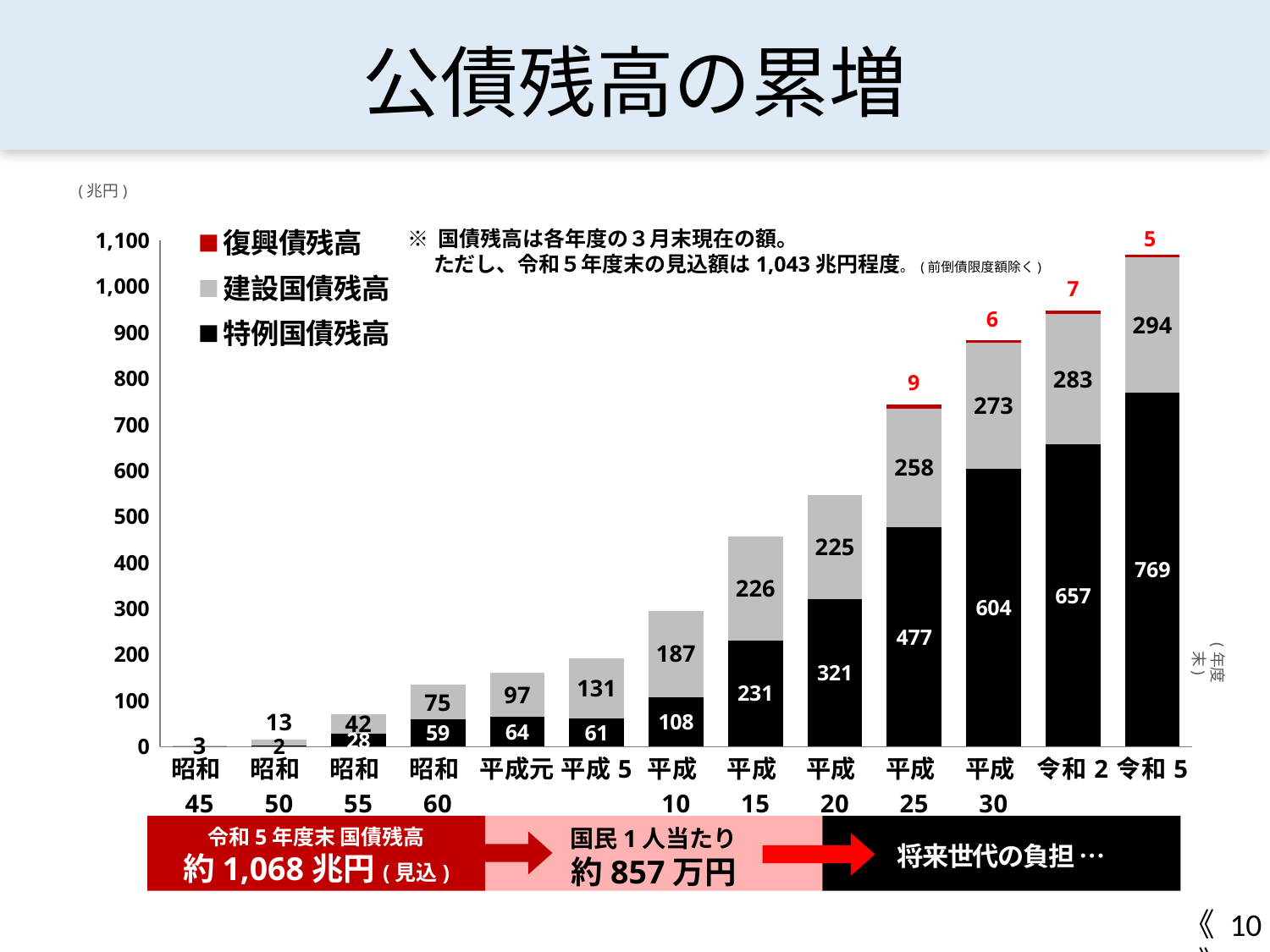
What is the value of 復興債残高 for 平成25? 9 What kind of chart is shown on the slide? Stacked bar chart How many years are shown on the x axis? 13 Which is larger for 平成15: 建設国債残高 or 特例国債残高? 特例国債残高 What is the difference between 特例国債残高 for 令和5 and 令和2? 112 What is the total of the stacked bar for 令和5? 1,068 Is the total stacked bar for 平成20 greater or less than 500? greater What is the value of 特例国債残高 for 令和5? 769 Which year has the lowest value of 建設国債残高? 昭和45 What is the value of 建設国債残高 for 平成20? 225 Which year has the highest value of 特例国債残高? 令和5 How many series does the legend list? 3